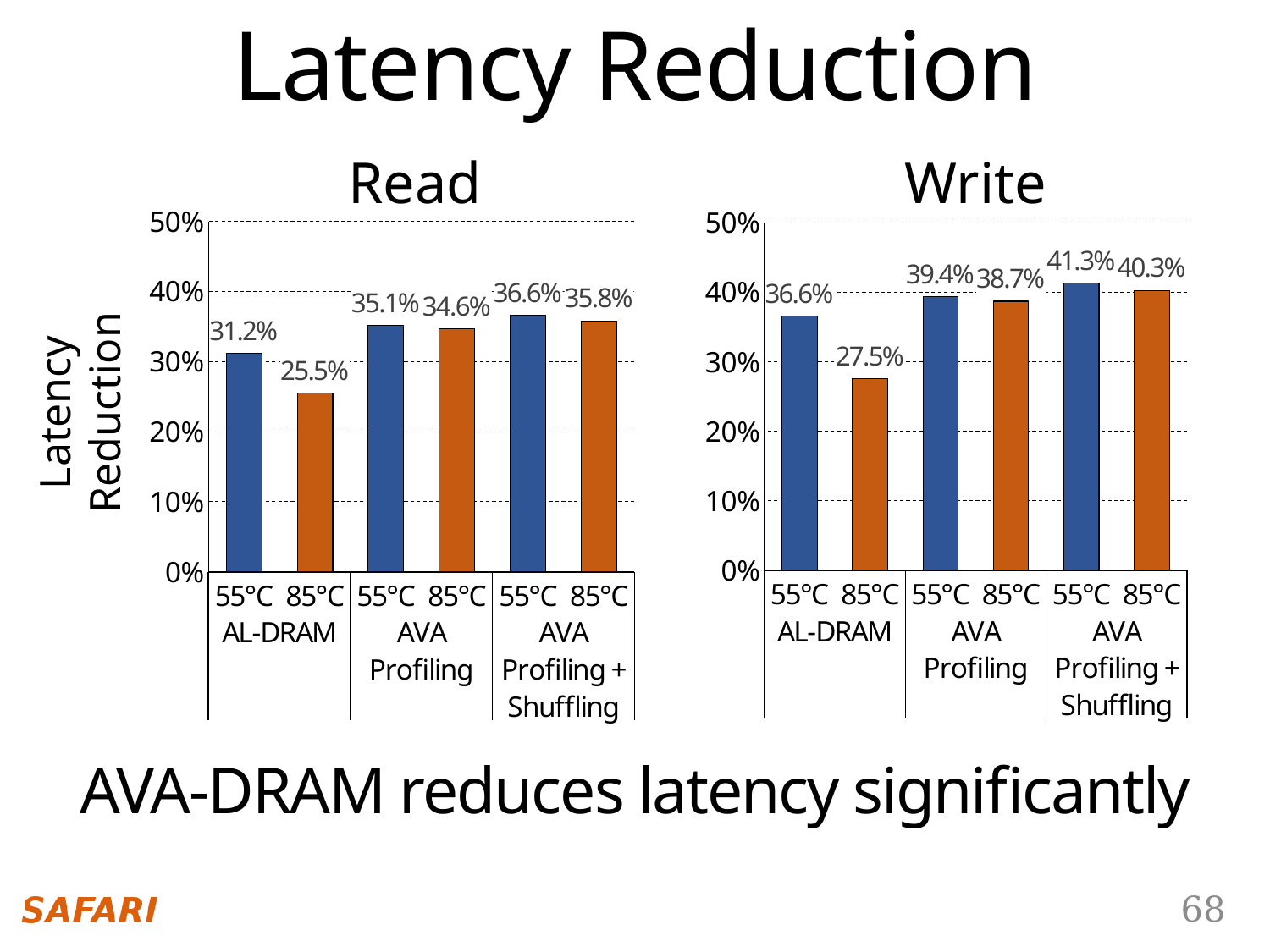
In the Write chart, what is the difference between the AVA Profiling + Shuffling 55°C and 85°C latency reductions? 1.0% In the Read chart, what is the latency reduction for AL-DRAM at 85°C? 25.5% In the Write chart, which bar has the highest latency reduction? AVA Profiling + Shuffling 55°C What is the y-axis label shared by the two charts? Latency Reduction In the Read chart, which bar has the lowest latency reduction? AL-DRAM 85°C What kind of chart is the Write chart? Bar chart In the Read chart, what is the latency reduction for AVA Profiling at 55°C? 35.1% In the Read chart, what is the difference between the AL-DRAM 55°C and AL-DRAM 85°C latency reductions? 5.7% How many bars are plotted in the Read chart? 6 In the Write chart, what is the latency reduction for AVA Profiling + Shuffling at 55°C? 41.3% In the Write chart, what is the latency reduction for AL-DRAM at 85°C? 27.5% In the Write chart, which is larger: the latency reduction for AL-DRAM at 55°C or for AL-DRAM at 85°C? AL-DRAM at 55°C